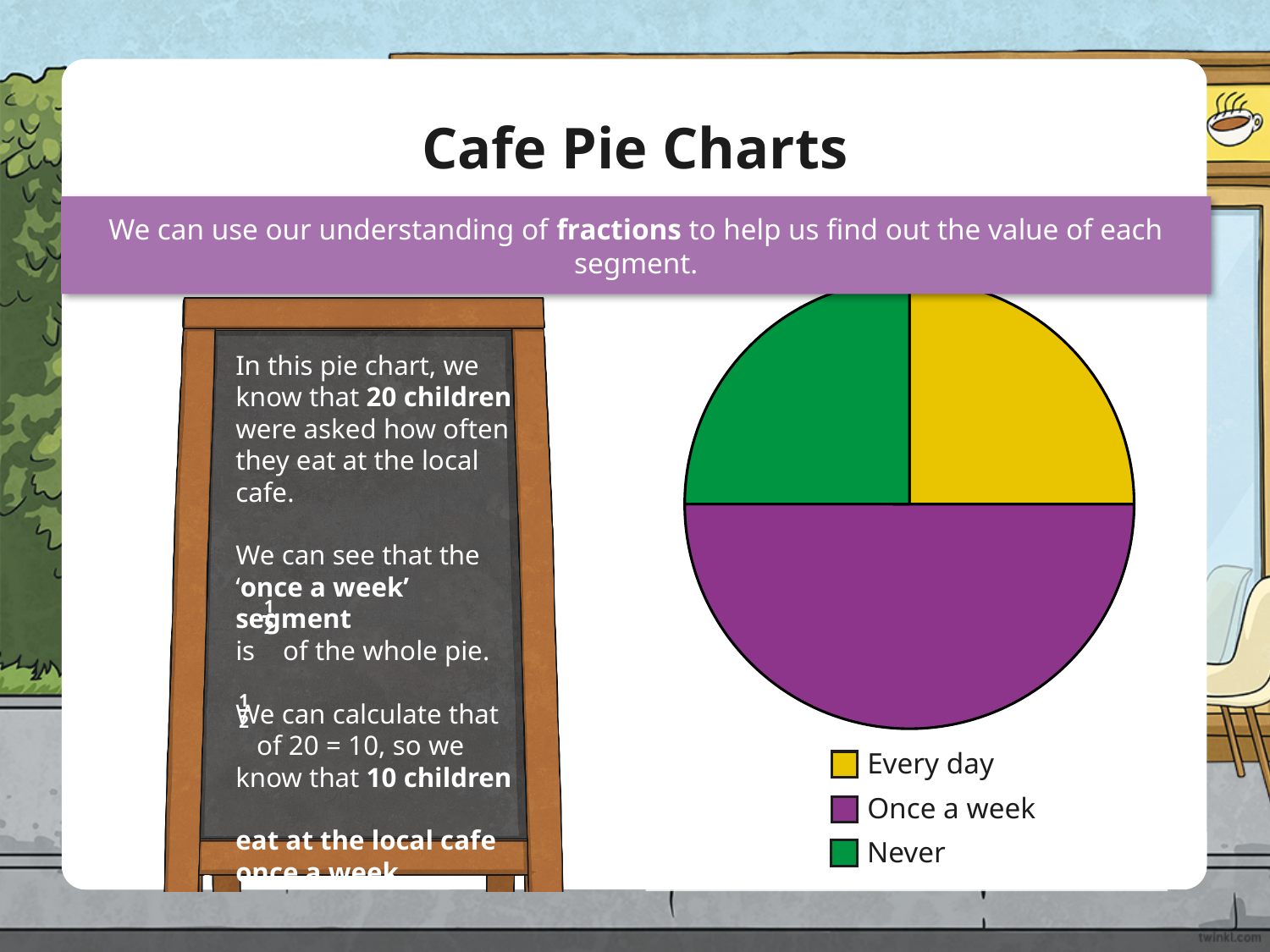
Which is larger in the pie chart, the 'Once a week' segment or the 'Never' segment? Once a week Which segment of the pie chart is the largest? Once a week What kind of chart is shown on the slide? pie chart What fraction of the whole pie is the 'Once a week' segment? 1/2 According to the slide, how many children were asked how often they eat at the local cafe? 20 Which is larger in the pie chart, the 'Once a week' segment or the 'Every day' segment? Once a week How many entries does the legend of the pie chart list? 3 What colour represents 'Never' in the pie chart? green How many segments does the pie chart have? 3 According to the slide, how many children eat at the local cafe once a week? 10 What is the title of the slide containing the pie chart? Cafe Pie Charts